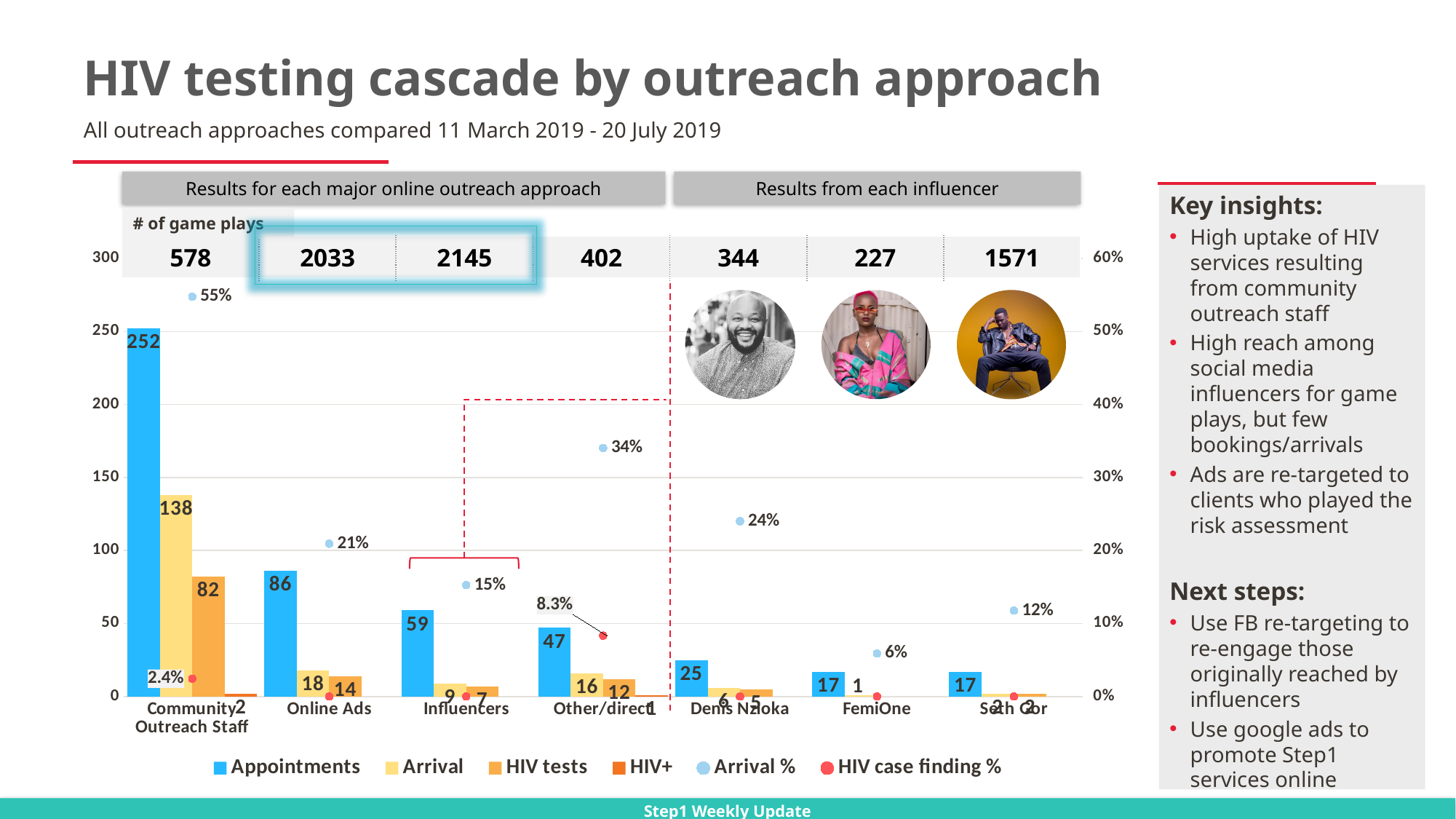
Which has more arrivals, Community Outreach Staff or Online Ads? Community Outreach Staff What is the difference in appointments between Online Ads and Influencers? 27 Which outreach approach has the highest number of appointments? Community Outreach Staff Which category has the highest Arrival %? Community Outreach Staff What is the Arrival % for Online Ads? 21% How many categories are shown on the x axis of the chart? 7 How many series does the chart legend list? 6 How many game plays are shown for Influencers? 2145 How many appointments are shown for Community Outreach Staff? 252 What kind of chart is used to show the Appointments, Arrival, HIV tests and HIV+ values? bar chart How many HIV tests are shown for Other/direct? 12 What is the HIV case finding % for Other/direct? 8.3%